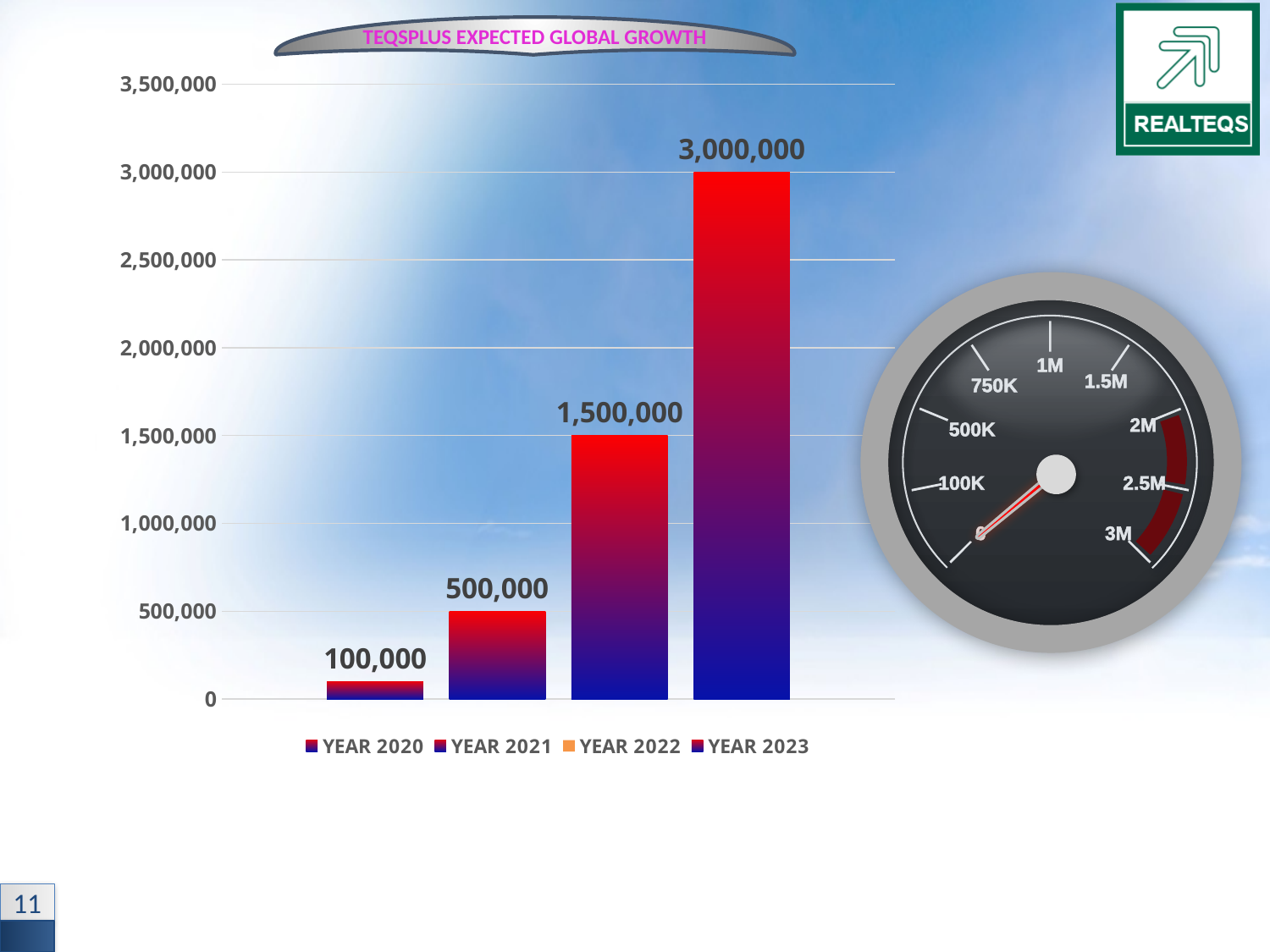
What is the title of the chart? TEQSPLUS EXPECTED GLOBAL GROWTH What kind of chart is shown on the slide? bar chart What is the value for YEAR 2021? 500,000 Which year has the lowest value? YEAR 2020 Which is larger, the value for YEAR 2021 or the value for YEAR 2020? YEAR 2021 Which year has the highest value? YEAR 2023 How many series does the legend list? 4 What is the difference between the values for YEAR 2023 and YEAR 2022? 1,500,000 Is the value for YEAR 2022 greater or less than 1,000,000? greater What is the value for YEAR 2022? 1,500,000 What is the value for YEAR 2020? 100,000 What is the value for YEAR 2023? 3,000,000